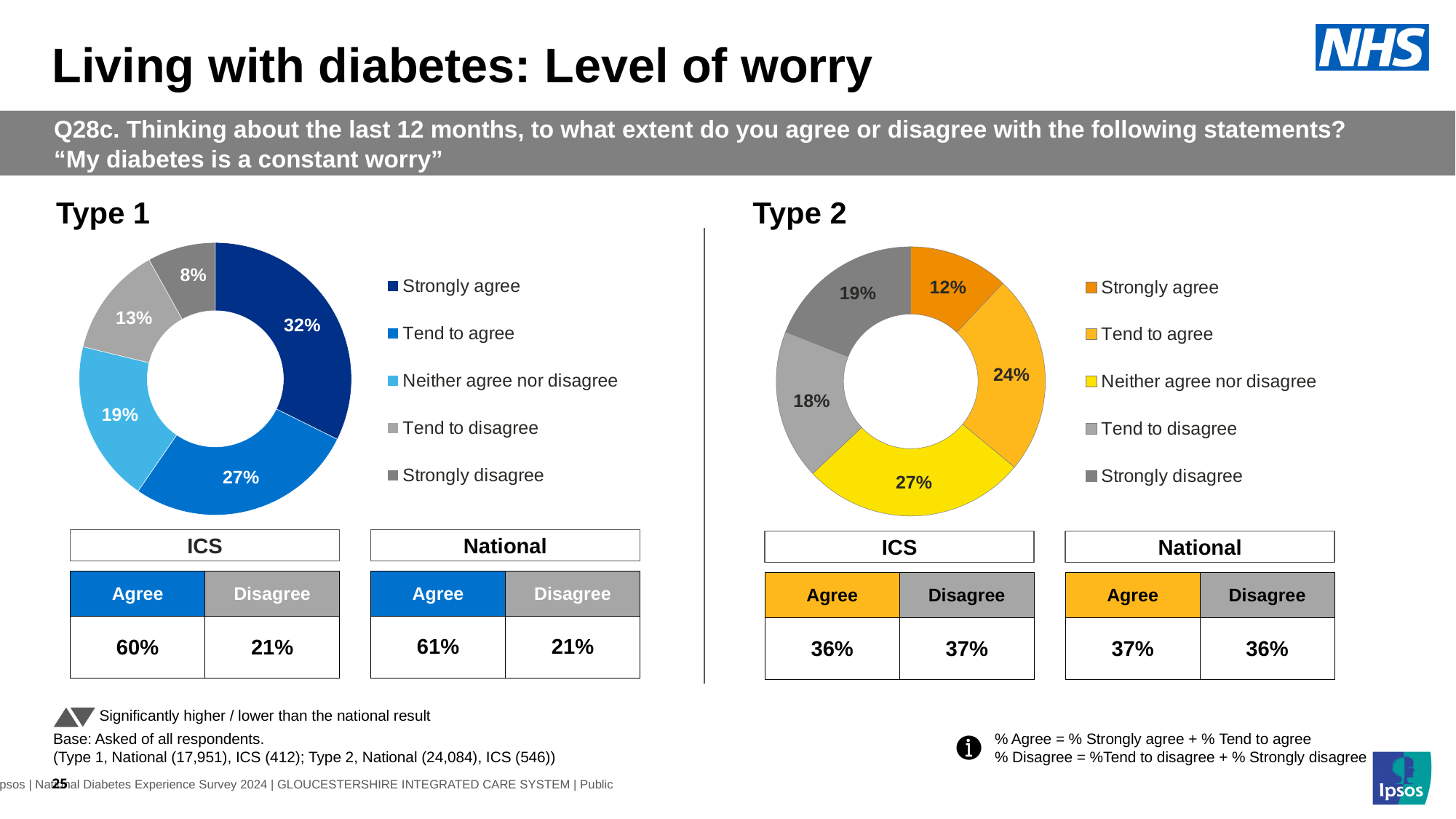
In the Type 2 chart, what is the combined share of Tend to disagree and Strongly disagree? 37% In the Type 2 chart, what is the difference between the Tend to agree and Strongly agree shares? 12% In the Type 2 chart, which response category has the smallest share? Strongly agree What kind of chart is used for Type 1? Doughnut chart In the Type 1 chart, which response category has the smallest share? Strongly disagree In the Type 1 chart, which is larger: Tend to agree or Neither agree nor disagree? Tend to agree In the Type 1 chart, what percentage of respondents strongly agree? 32% In the Type 2 chart, what percentage of respondents neither agree nor disagree? 27% In the Type 1 chart, what is the combined share of Strongly agree and Tend to agree? 59% In the Type 1 chart, which response category has the largest share? Strongly agree In the Type 2 chart, what colour represents Neither agree nor disagree? Yellow How many response categories does the Type 2 chart's legend list? 5